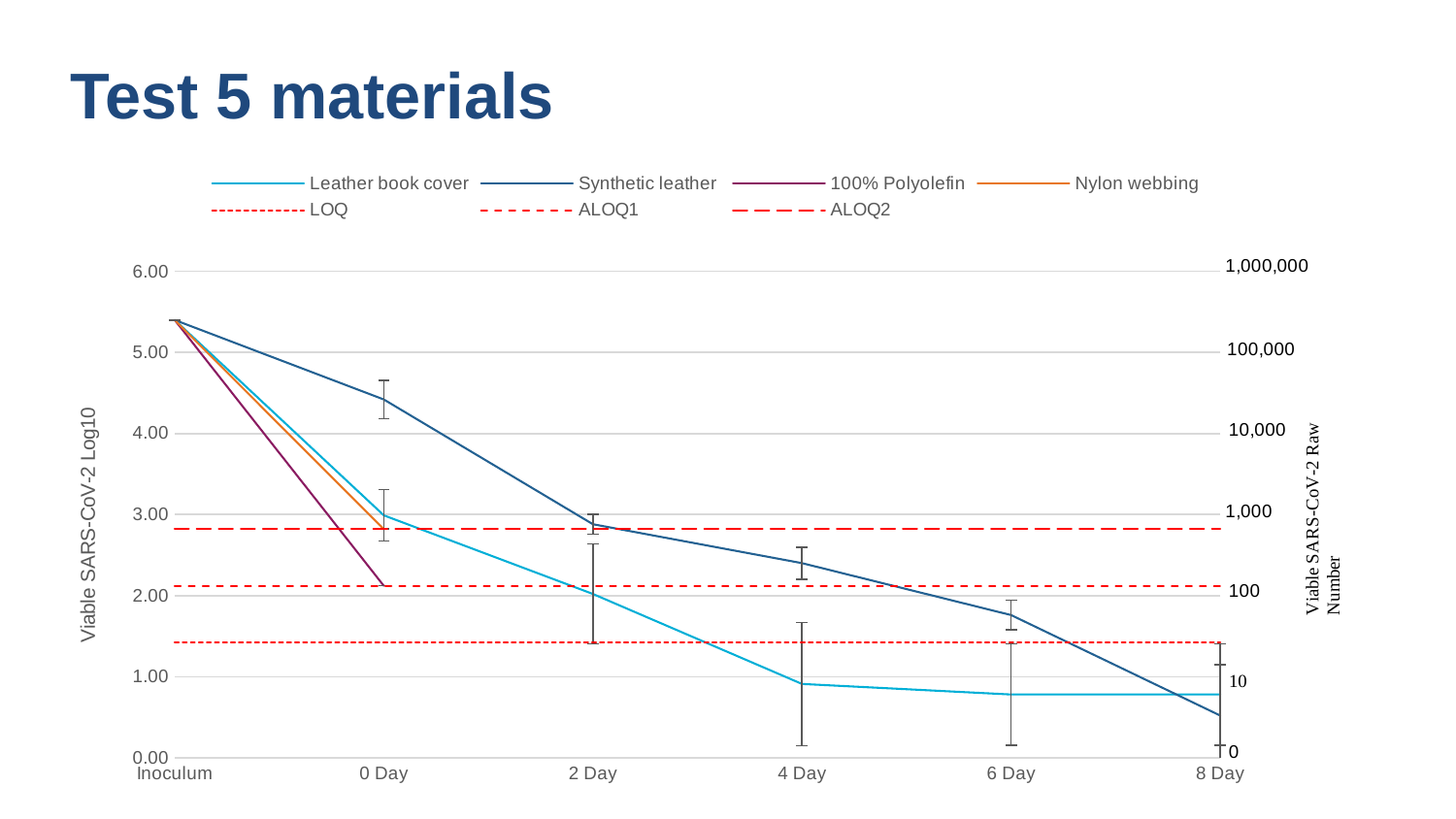
What is the title of the slide? Test 5 materials What is the title of the left vertical axis? Viable SARS-CoV-2 Log10 Is the value for Synthetic leather at 4 Day greater or less than 2.00? greater Is the value for Synthetic leather at 8 Day greater or less than 1.00? less Is the value for Synthetic leather at 0 Day greater or less than 4.00? greater Which material has the highest value at 0 Day? Synthetic leather Does the Synthetic leather line rise or fall from Inoculum to 8 Day? Fall What kind of chart is shown on the slide? Line chart Which material has the lowest value at 0 Day? 100% Polyolefin How many categories are shown along the x axis? 6 How many entries does the chart legend list? 7